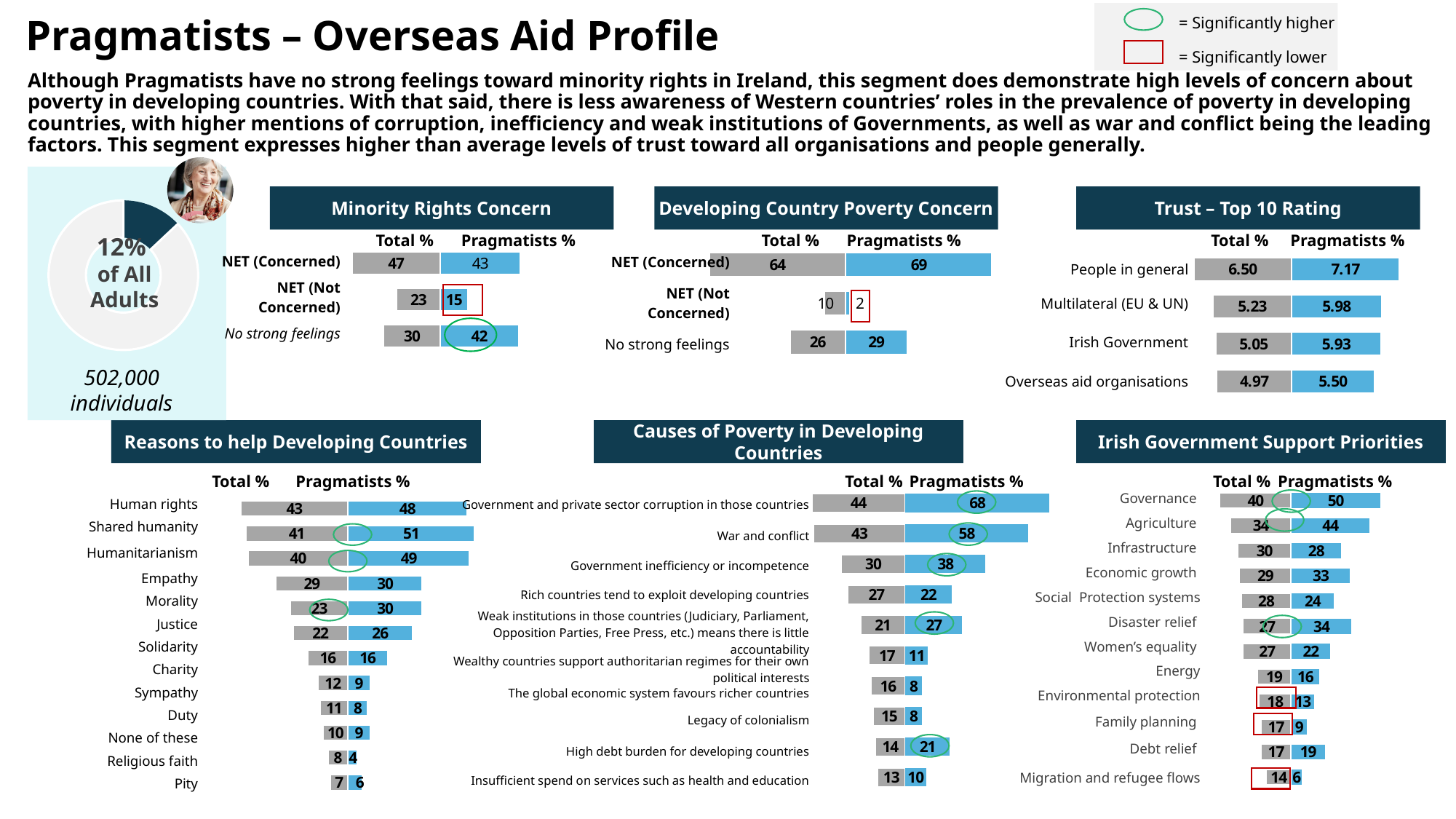
What type of chart is used in the 'Reasons to help Developing Countries' section? Bar chart In the 'Trust – Top 10 Rating' chart, what is the Pragmatists rating for 'Irish Government'? 5.93 In the 'Reasons to help Developing Countries' chart, how many reasons are listed? 13 In the 'Developing Country Poverty Concern' chart, what is the difference between the Pragmatists % and Total % for 'NET (Concerned)'? 5 In the 'Causes of Poverty in Developing Countries' chart, what is the Pragmatists % for 'War and conflict'? 58 In the 'Irish Government Support Priorities' chart, what is the Pragmatists % for 'Migration and refugee flows'? 6 In the 'Reasons to help Developing Countries' chart, which reason has the highest Pragmatists %? Shared humanity In the 'Developing Country Poverty Concern' chart, what is the Pragmatists % for 'NET (Concerned)'? 69 In the 'Causes of Poverty in Developing Countries' chart, what is the difference between the Pragmatists % and Total % for 'Government and private sector corruption in those countries'? 24 In the 'Minority Rights Concern' chart, what is the Pragmatists % for 'No strong feelings'? 42 In the 'Irish Government Support Priorities' chart, which is larger for 'Disaster relief': the Total % or the Pragmatists %? Pragmatists % In the 'Trust – Top 10 Rating' chart, which category has the lowest Total rating? Overseas aid organisations